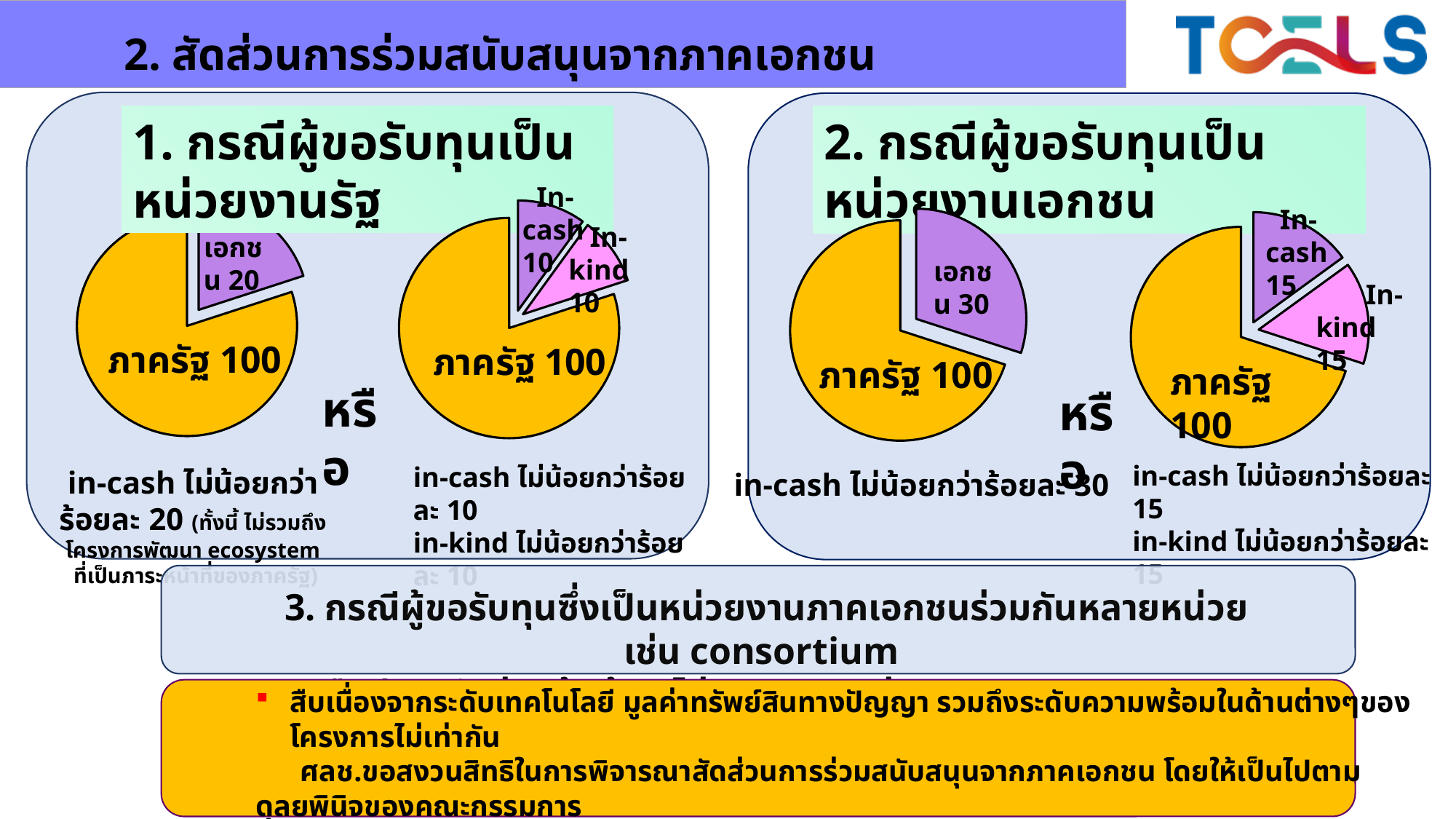
What kind of chart is the leftmost chart in the panel '1. กรณีผู้ขอรับทุนเป็นหน่วยงานรัฐ'? pie chart In the second pie chart of the panel '1. กรณีผู้ขอรับทุนเป็นหน่วยงานรัฐ', what value is shown for In-cash? 10 In the leftmost pie chart of the panel '2. กรณีผู้ขอรับทุนเป็นหน่วยงานเอกชน', what value is shown for เอกชน? 30 In the rightmost pie chart of the panel '2. กรณีผู้ขอรับทุนเป็นหน่วยงานเอกชน', which slice is the largest? ภาครัฐ In the leftmost pie chart of the panel '2. กรณีผู้ขอรับทุนเป็นหน่วยงานเอกชน', which slice is the smallest? เอกชน Which is larger: the เอกชน value in the leftmost pie of panel 1 (หน่วยงานรัฐ) or the เอกชน value in the leftmost pie of panel 2 (หน่วยงานเอกชน)? panel 2 (หน่วยงานเอกชน), 30 In the leftmost pie chart of the panel '1. กรณีผู้ขอรับทุนเป็นหน่วยงานรัฐ', what is the difference between the ภาครัฐ value and the เอกชน value? 80 In the rightmost pie chart of the panel '2. กรณีผู้ขอรับทุนเป็นหน่วยงานเอกชน', what value is shown for In-kind? 15 How many pie charts are shown on the slide in total? 4 In the leftmost pie chart of the panel '1. กรณีผู้ขอรับทุนเป็นหน่วยงานรัฐ', what value is shown for เอกชน? 20 In the leftmost pie chart of the panel '1. กรณีผู้ขอรับทุนเป็นหน่วยงานรัฐ', what value is shown for ภาครัฐ? 100 In the second pie chart of the panel '1. กรณีผู้ขอรับทุนเป็นหน่วยงานรัฐ', how many slices does the pie have? 3